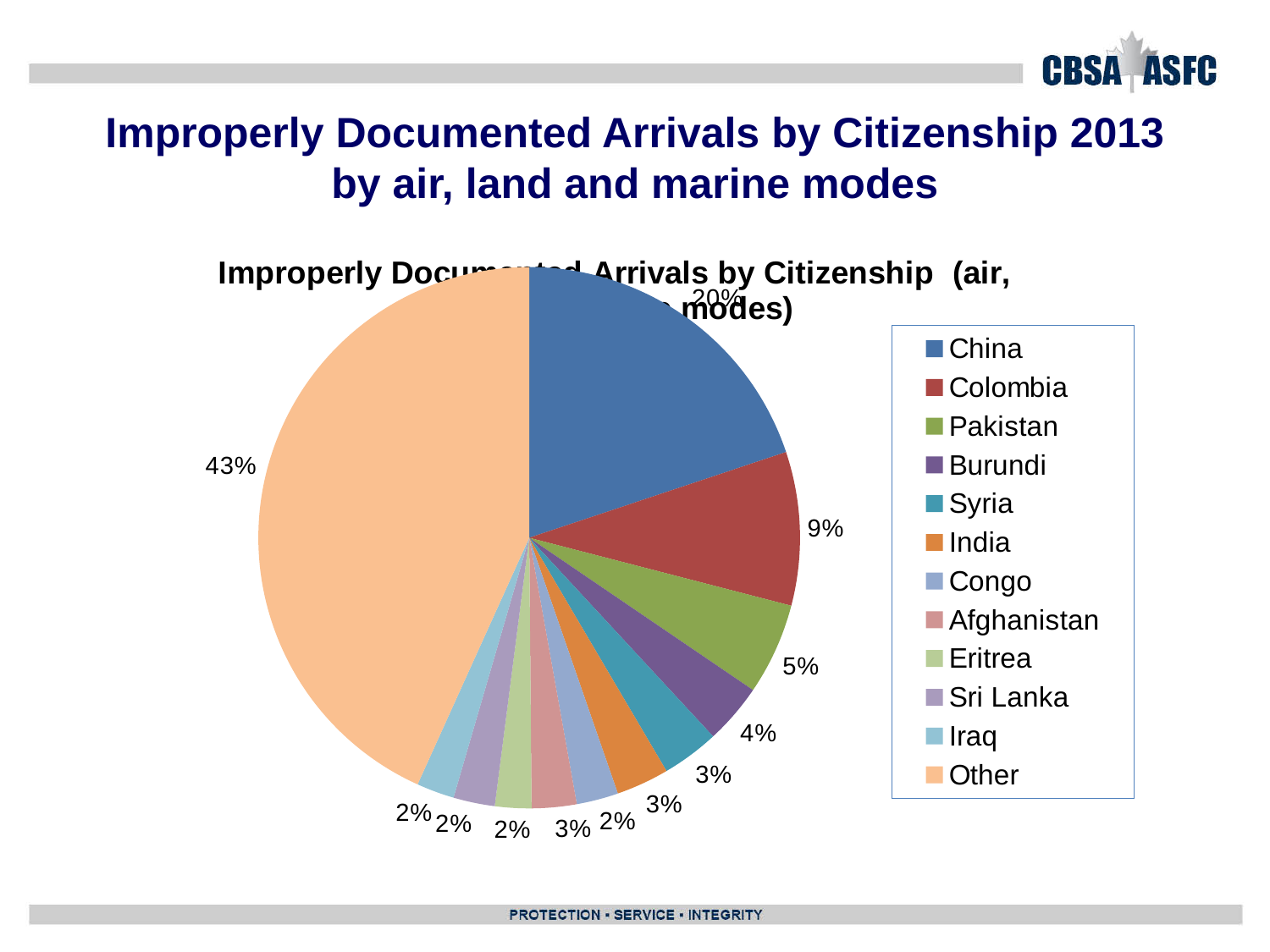
Which category is listed first in the legend? China Which is larger, the share for Colombia or the share for Pakistan? Colombia What percentage is shown for Colombia? 9% Which category has the largest slice of the pie? Other What percentage is shown for Pakistan? 5% How many citizenship categories does the legend list? 12 What is the difference in percentage points between Colombia and Pakistan? 4% What kind of chart is shown on the slide? pie chart What percentage is shown for Burundi? 4% What share of improperly documented arrivals is labelled for Other? 43% What is the difference in percentage points between the Other slice and the China slice? 23% What percentage is shown for China? 20%